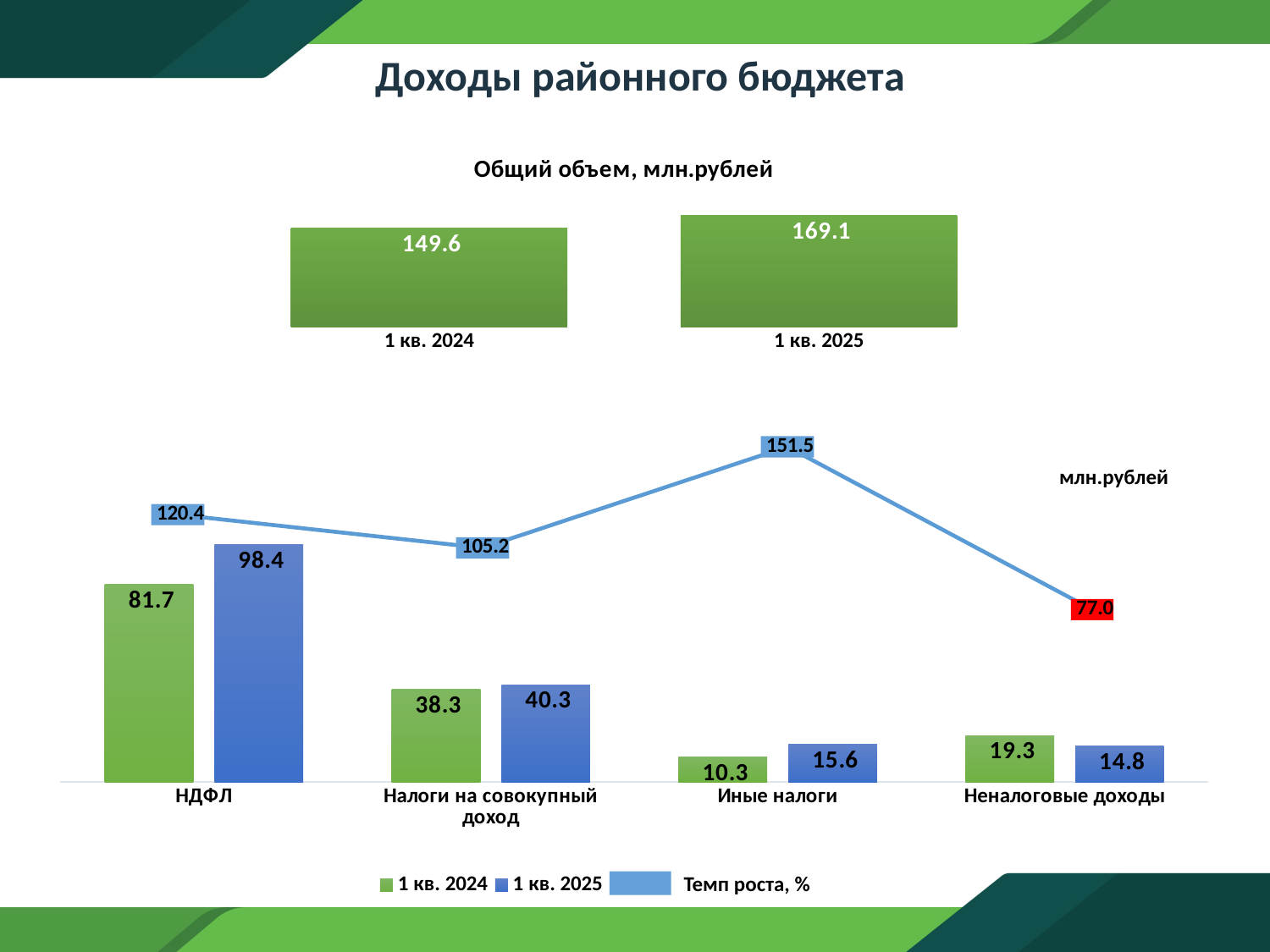
In the top chart 'Общий объем, млн.рублей', what is the difference between 1 кв. 2025 and 1 кв. 2024? 19.5 In the bottom chart, what is the 1 кв. 2025 value for Иные налоги? 15.6 How many series does the legend of the bottom chart list? 3 In the bottom chart, what is the difference between the 1 кв. 2025 and 1 кв. 2024 values for НДФЛ? 16.7 In the top chart 'Общий объем, млн.рублей', which period has the higher value? 1 кв. 2025 How many categories are shown on the x axis of the bottom chart? 4 In the bottom chart, for Неналоговые доходы, which is larger: the 1 кв. 2024 value or the 1 кв. 2025 value? 1 кв. 2024 In the bottom chart, which category has the lowest 1 кв. 2024 value? Иные налоги In the bottom chart, which category has the highest Темп роста, %? Иные налоги In the top chart 'Общий объем, млн.рублей', what is the value for 1 кв. 2025? 169.1 In the bottom chart, what is the 1 кв. 2024 value for НДФЛ? 81.7 In the bottom chart, what is the Темп роста, % value for Неналоговые доходы? 77.0